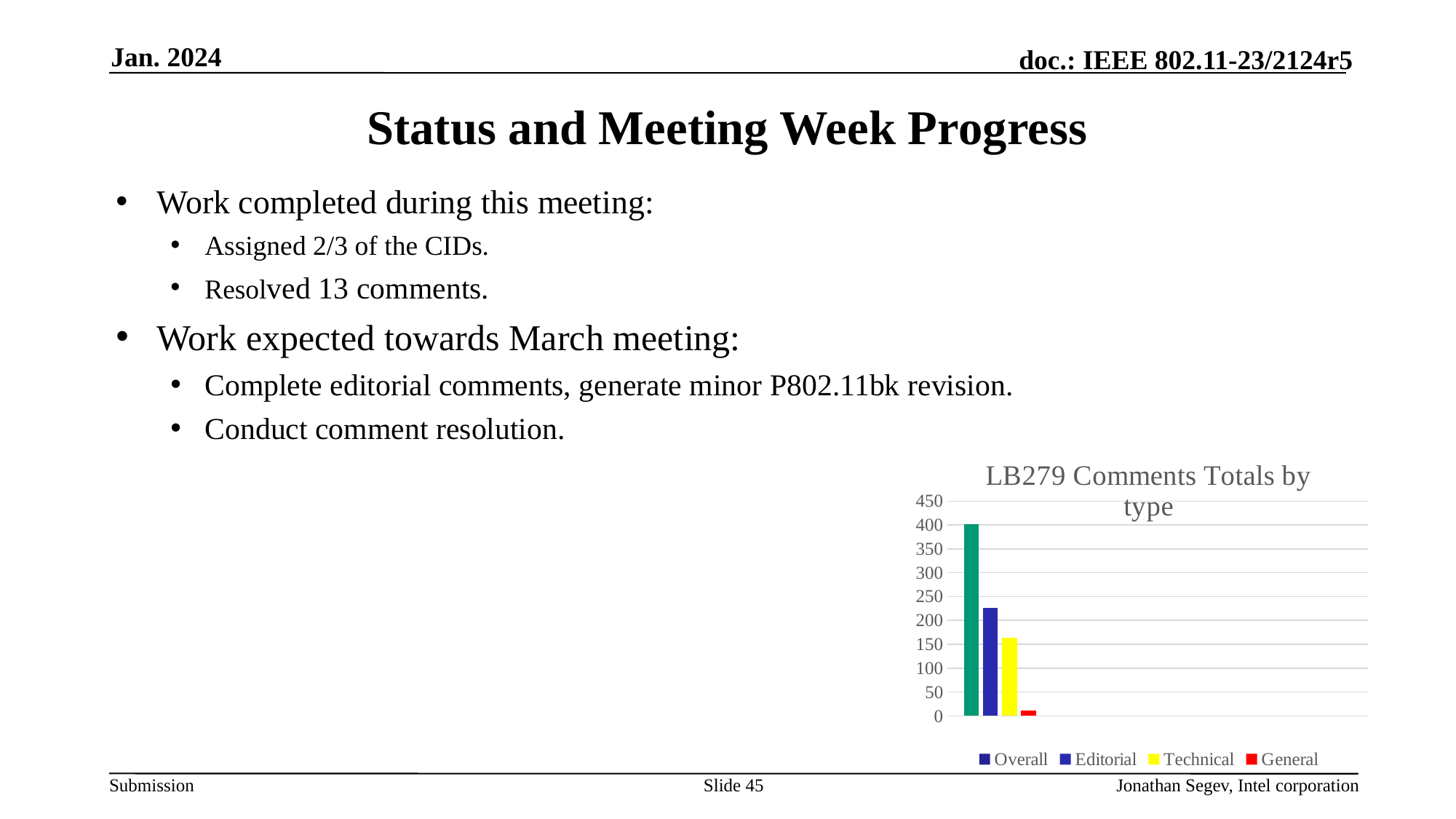
Which series has the highest value in the chart? Overall How many series does the chart legend list? 4 What colour is the bar for the Technical series? yellow Which series has the lowest value in the chart? General Is the value for Technical greater or less than 100? greater Is the value for Editorial greater or less than 200? greater Is the value for General greater or less than 50? less What kind of chart is shown on the slide? bar chart Which is larger, the value for Editorial or the value for Technical? Editorial What is the title of the chart on the slide? LB279 Comments Totals by type